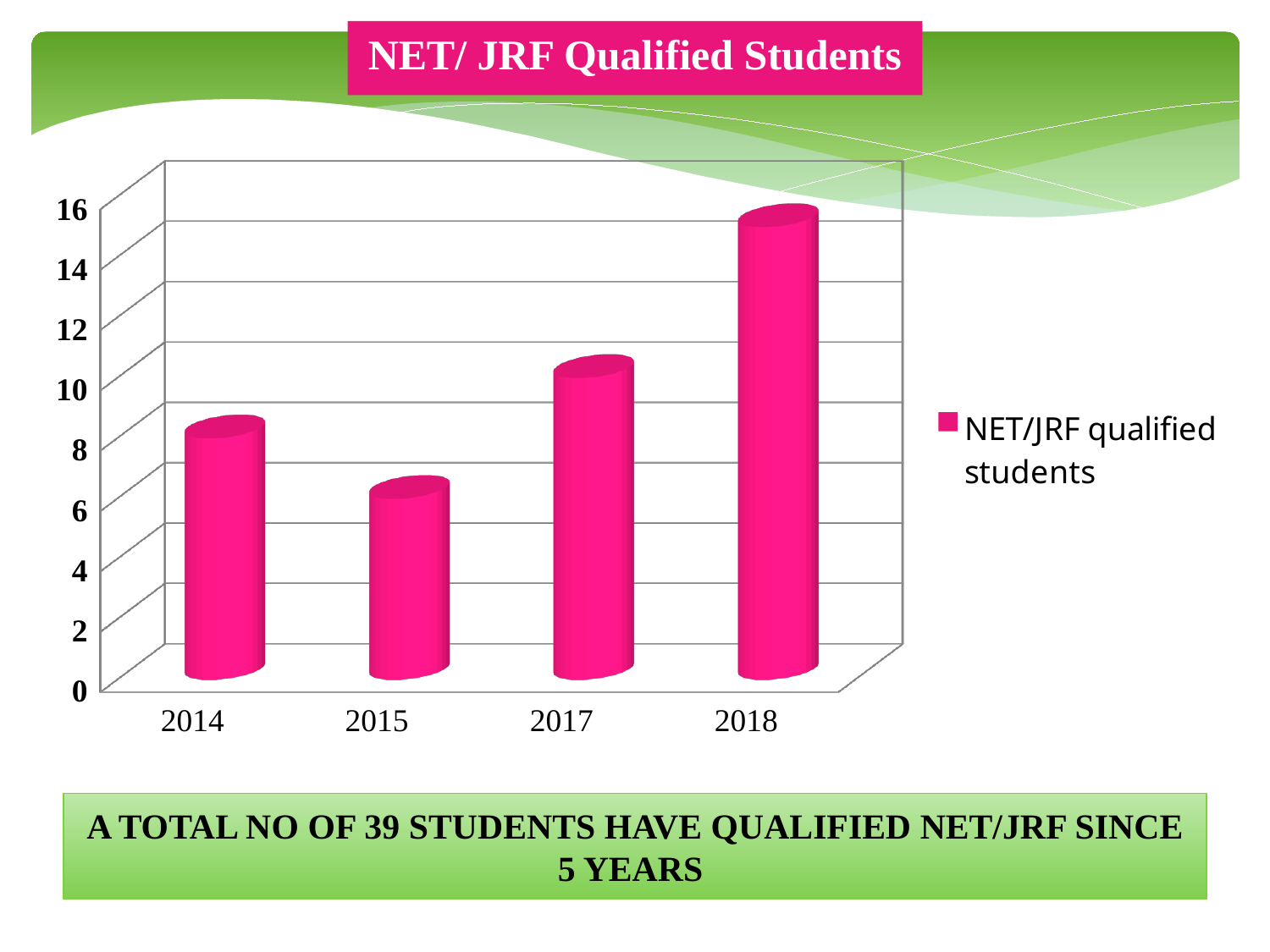
How many years are shown on the x axis of the chart? 4 What is the title of the chart? NET/ JRF Qualified Students Is the value for 2014 greater or less than 6? greater Is the value for 2018 greater or less than 14? greater From 2015 to 2018, do the values rise or fall? rise How many series does the legend list? 1 Which year has more NET/JRF qualified students, 2014 or 2017? 2017 Is the value for 2015 greater or less than 8? less Which year has the lowest number of NET/JRF qualified students? 2015 What kind of chart is shown on the slide? bar chart Which year has the highest number of NET/JRF qualified students? 2018